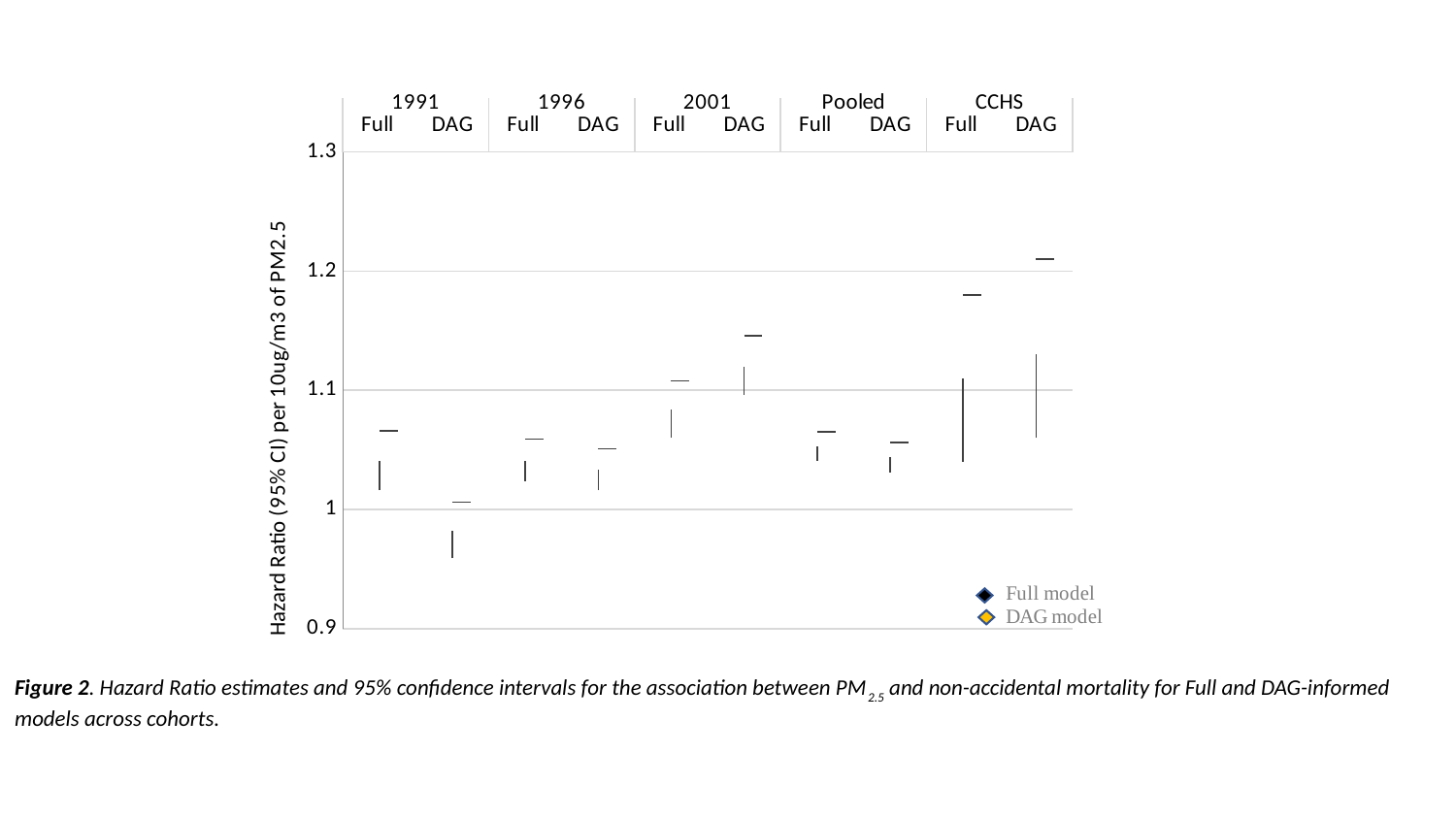
Is the hazard ratio estimate for the 1991 Full model greater or less than 1.1? less For the 2001 cohort, which model has the higher hazard ratio estimate, Full or DAG? DAG How many cohorts are shown along the x axis? 5 Is the hazard ratio estimate for the 2001 DAG model greater or less than 1.1? greater What are the two entries in the legend? Full model, DAG model Which cohort shows the highest hazard ratio estimates? CCHS What is the label of the y axis? Hazard Ratio (95% CI) per 10ug/m3 of PM2.5 How many series does the legend list? 2 Is the hazard ratio estimate for the CCHS Full model greater or less than 1.2? less Which cohort and model shows the lowest hazard ratio estimate? 1991 DAG